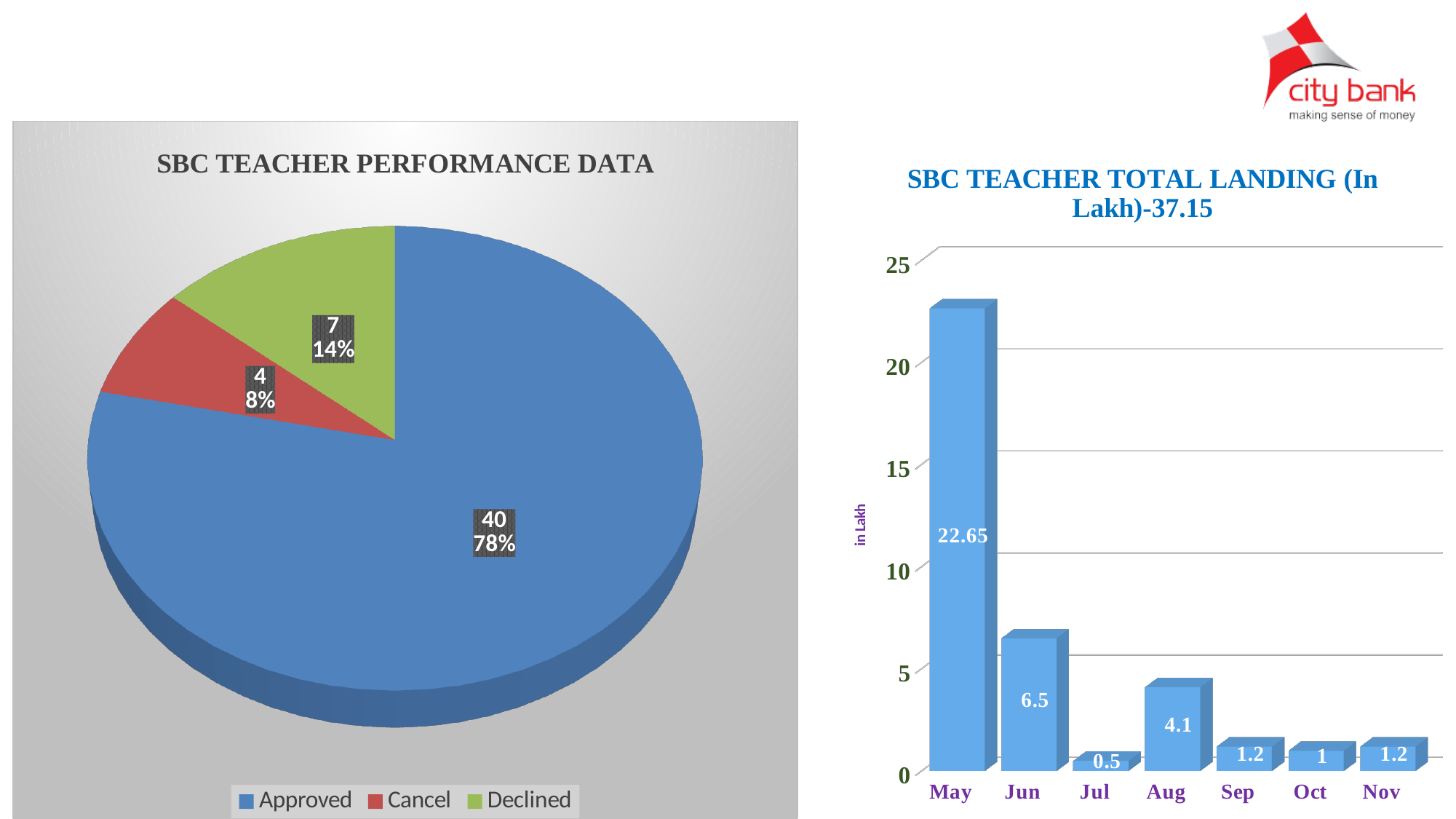
What kind of chart is the SBC TEACHER PERFORMANCE DATA chart? Pie chart In the SBC TEACHER PERFORMANCE DATA pie chart, which category has the smallest slice? Cancel How many categories does the legend of the SBC TEACHER PERFORMANCE DATA pie chart list? 3 In the SBC TEACHER PERFORMANCE DATA pie chart, what is the value for Approved? 40 In the SBC TEACHER TOTAL LANDING chart, what is the difference between the values for May and Jun? 16.15 In the SBC TEACHER PERFORMANCE DATA pie chart, what share of the pie is Cancel? 8% In the SBC TEACHER TOTAL LANDING chart, is the value for Jun greater or less than 5? greater In the SBC TEACHER PERFORMANCE DATA pie chart, what share of the pie is Declined? 14% In the SBC TEACHER TOTAL LANDING chart, which month has the lowest value? Jul How many months are shown on the x axis of the SBC TEACHER TOTAL LANDING chart? 7 In the SBC TEACHER TOTAL LANDING chart, what is the value for May? 22.65 In the SBC TEACHER TOTAL LANDING chart, what is the value for Aug? 4.1